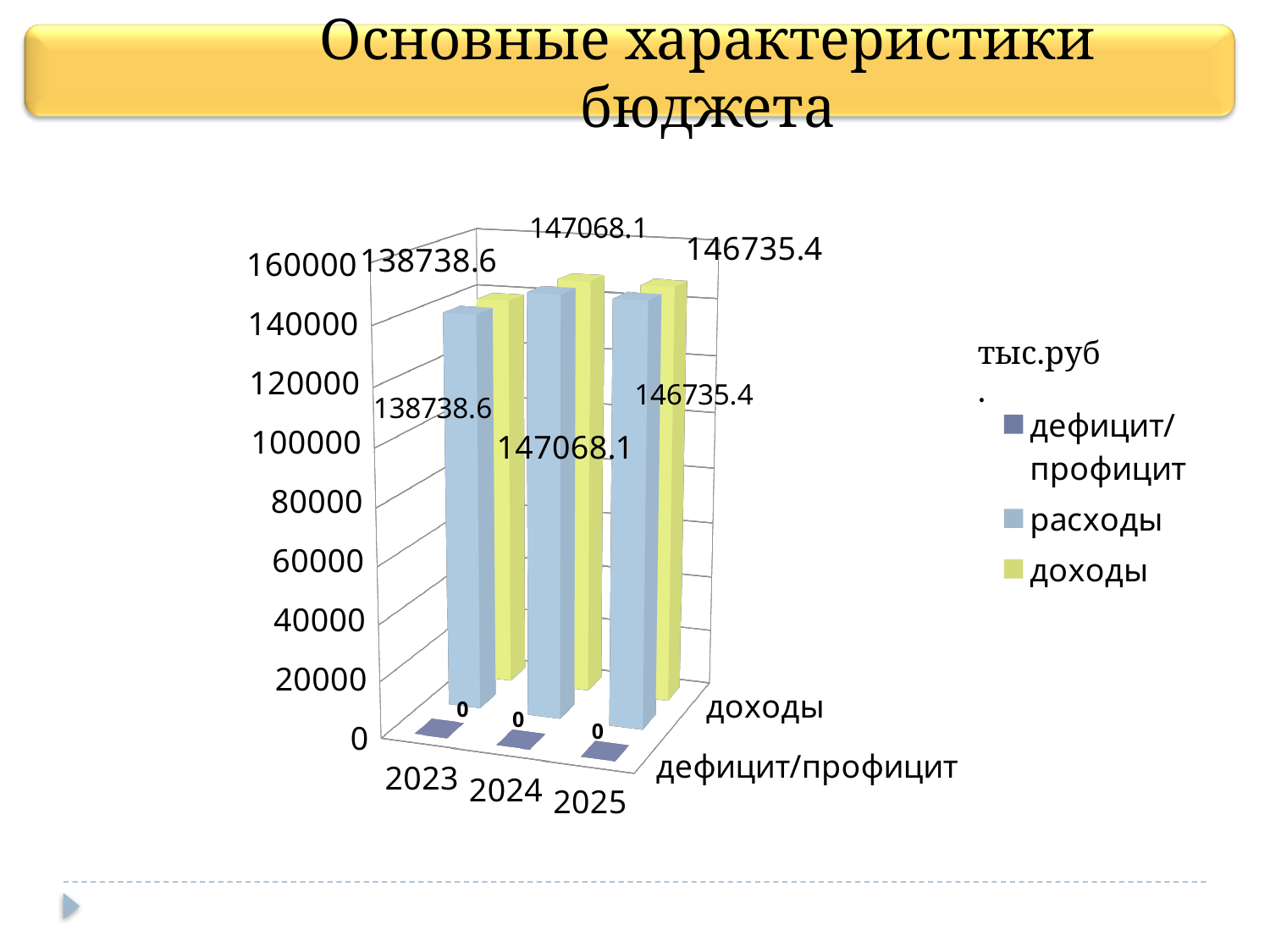
How many series does the legend list? 3 What is the value of расходы for 2023? 138738.6 How many years are shown on the x axis? 3 Which year has the lowest value for расходы? 2023 What is the value of доходы for 2025? 146735.4 What is the value of доходы for 2024? 147068.1 Which year has the highest value for доходы? 2024 What kind of chart is shown on the slide? bar chart What is the value of дефицит/профицит for 2025? 0 What is the difference between доходы in 2024 and доходы in 2023? 8329.5 What unit is indicated next to the legend? тыс.руб. Is the value of расходы for 2024 greater or less than 140000? greater